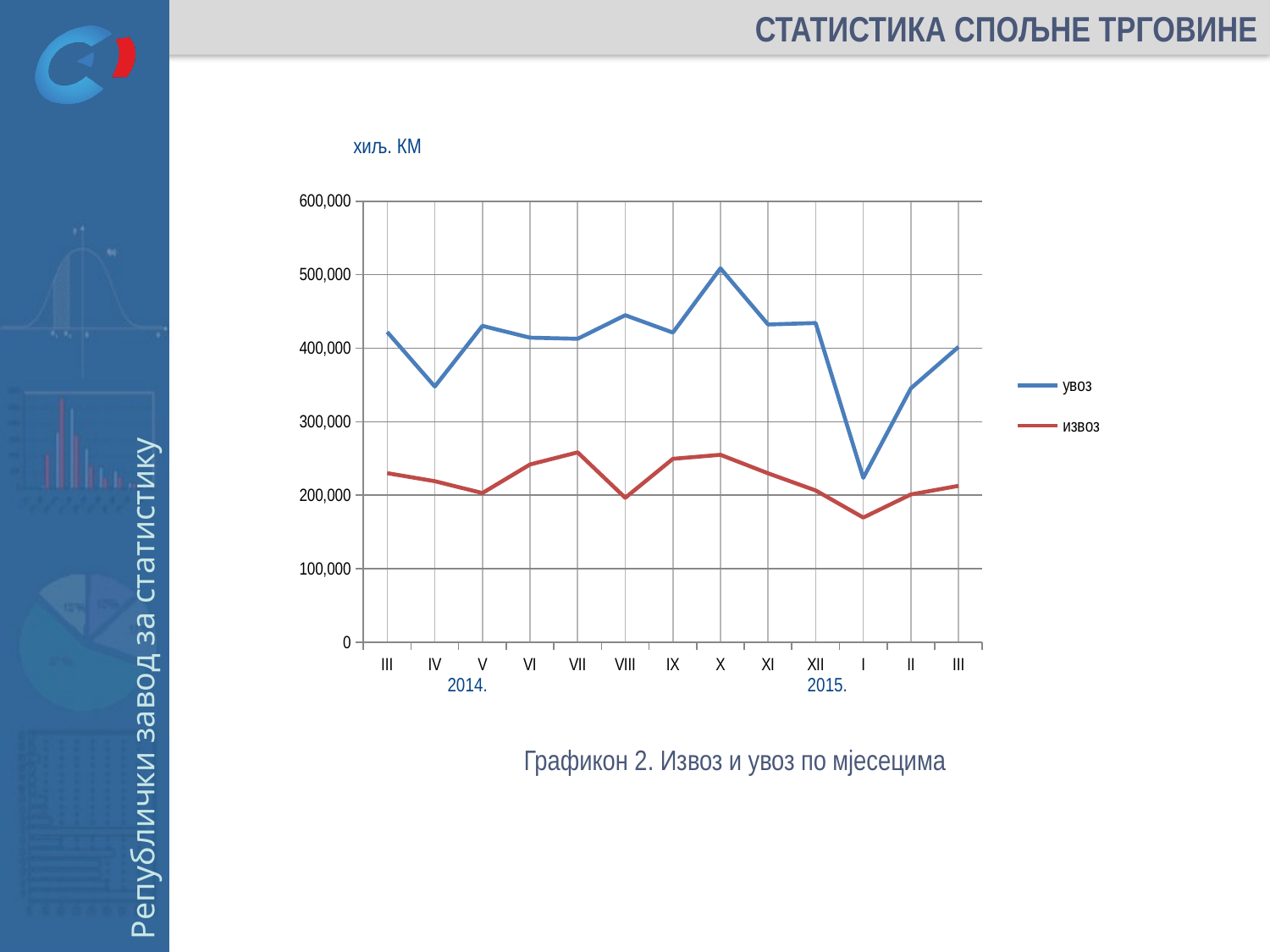
Does the value for увоз rise or fall from XII 2014 to I 2015? fall In which month is the value for увоз lowest? I 2015 Which series has the larger value in X 2014, увоз or извоз? увоз What unit is stated above the chart? хиљ. КМ What kind of chart is shown on the slide? line chart How many series does the legend list? 2 How many monthly points are plotted along the x axis? 13 Is the value for увоз in I 2015 greater or less than 300,000? less Is the value for извоз in VII 2014 greater or less than 200,000? greater In which month is the value for увоз highest? X 2014 In which month is the value for извоз lowest? I 2015 Is the value for увоз in IV 2014 greater or less than 400,000? less